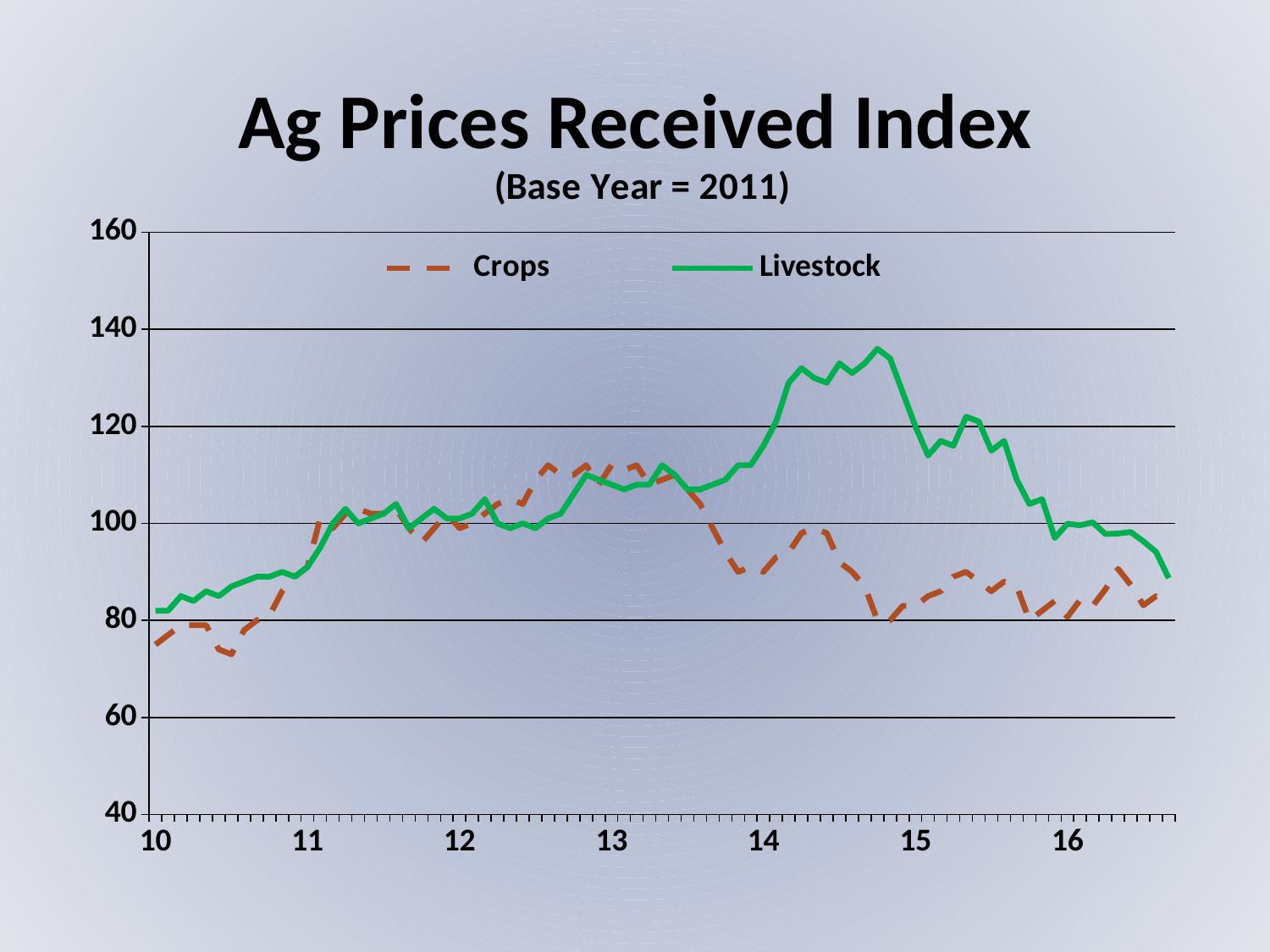
Is the Crops value during 2016 greater or less than 100? less Is the Crops value at the start of 2010 greater or less than 80? less How many series does the legend list? 2 Does the Livestock series rise or fall from its 2014 peak to the end of 2016? fall Is the peak value of the Livestock series in late 2014 greater or less than 120? greater During 2015, which series is higher, Crops or Livestock? Livestock What are the two series named in the legend? Crops and Livestock What is the title of the chart? Ag Prices Received Index How many year labels are shown on the x axis? 7 At the start of 2010, which series is higher, Crops or Livestock? Livestock Which series reaches the highest value anywhere on the chart? Livestock What kind of chart is shown on the slide? line chart